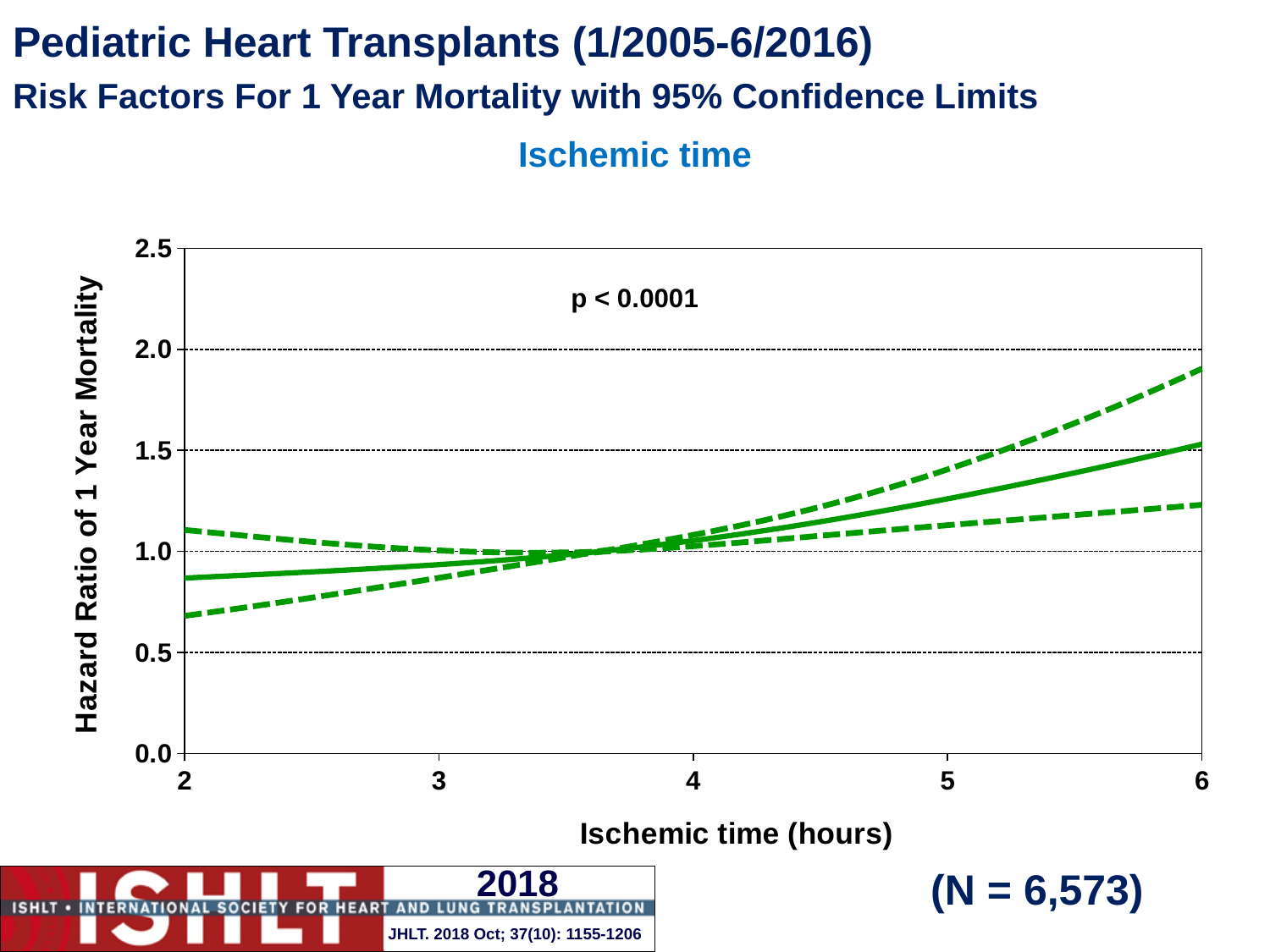
Is the hazard ratio (solid line) at an ischemic time of 2 hours greater or less than 1.0? less Is the lower 95% confidence limit (lower dashed line) at 6 hours greater or less than 1.0? greater What kind of chart is shown on the slide? line chart Is the upper 95% confidence limit (upper dashed line) at 6 hours greater or less than 2.0? less What is the label of the x axis? Ischemic time (hours) Is the hazard ratio (solid line) higher at 6 hours or at 2 hours of ischemic time? 6 hours Does the solid hazard ratio line rise or fall as ischemic time increases from 2 to 6 hours? rise What p-value is printed on the chart? p < 0.0001